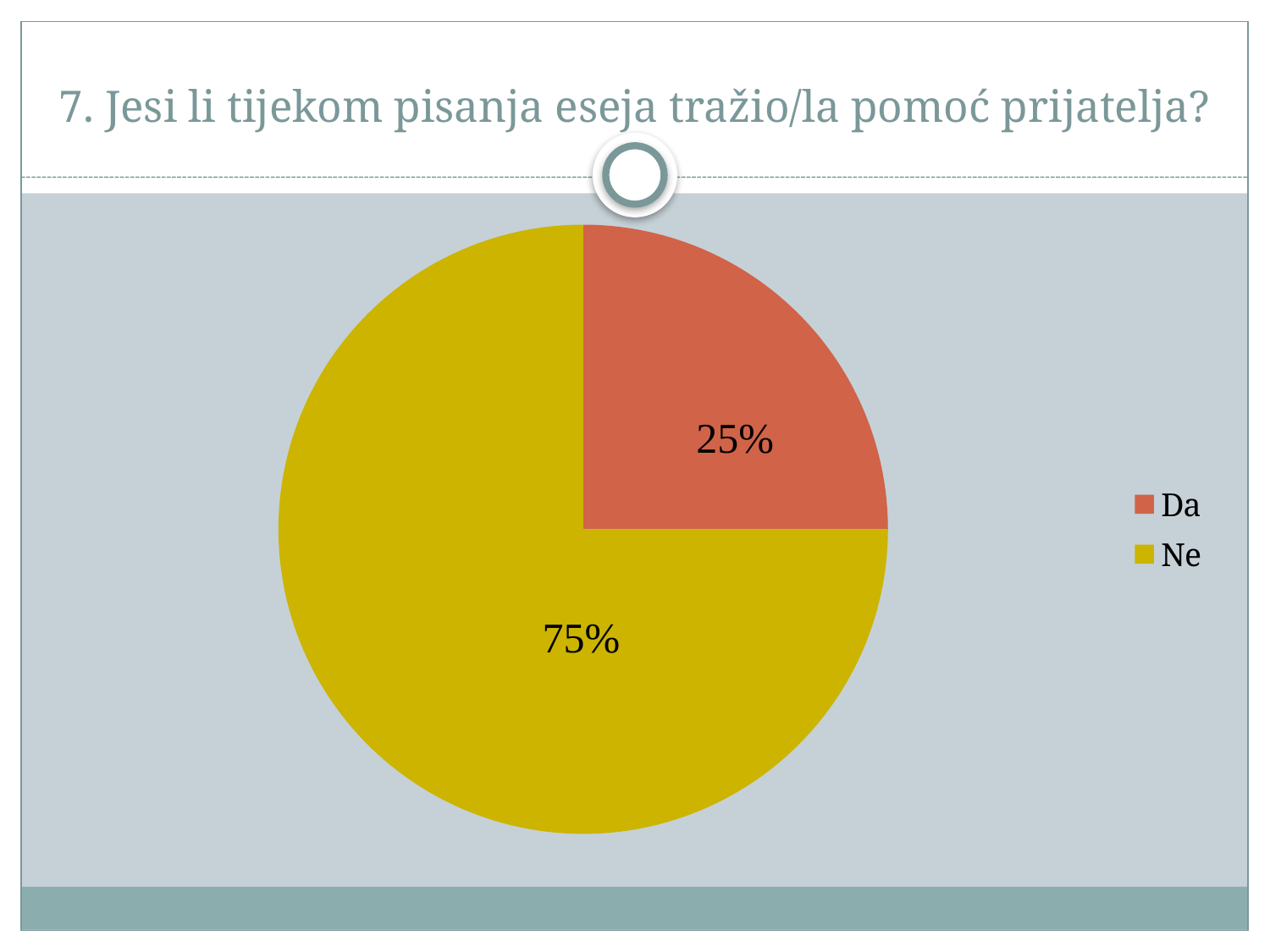
Which slice is larger, "Da" or "Ne"? Ne What is the difference in percentage points between the "Ne" and "Da" slices? 50 Which category has the largest slice of the pie? Ne What share of the pie does "Ne" represent? 75% What colour is the "Da" slice? red What colour is the "Ne" slice? yellow What kind of chart is shown on the slide? pie chart How many categories does the pie chart show? 2 Which category has the smallest slice of the pie? Da What share of the pie does "Da" represent? 25% How many entries does the legend list? 2